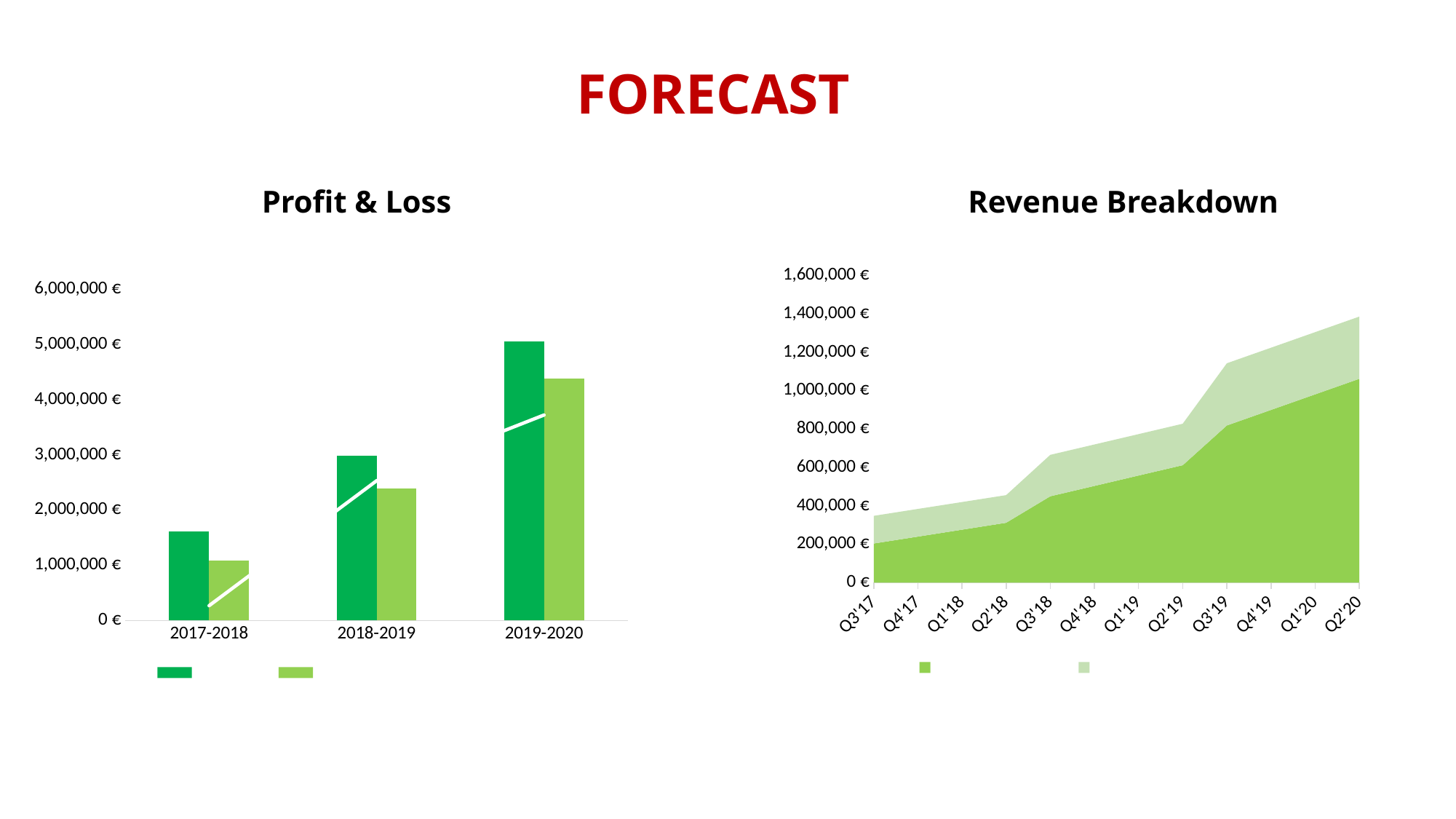
In the Profit & Loss chart, for 2018-2019, which bar is taller: the dark green or the light green? Dark green In the Revenue Breakdown chart, is the total stacked value at Q2'20 greater or less than 1,200,000 €? greater What kind of chart is the Revenue Breakdown chart? Stacked area chart How many series does the legend of the Revenue Breakdown chart list? 2 In the Profit & Loss chart, which category has the tallest dark green bar? 2019-2020 How many quarters are shown on the x axis of the Revenue Breakdown chart? 12 What kind of chart is the Profit & Loss chart? Combination bar and line chart How many categories are shown on the x axis of the Profit & Loss chart? 3 In the Profit & Loss chart, is the dark green bar for 2019-2020 greater or less than 4,000,000 €? greater In the Profit & Loss chart, is the light green bar for 2017-2018 greater or less than 2,000,000 €? less In the Revenue Breakdown chart, does the total stacked revenue rise or fall from Q3'17 to Q2'20? Rises